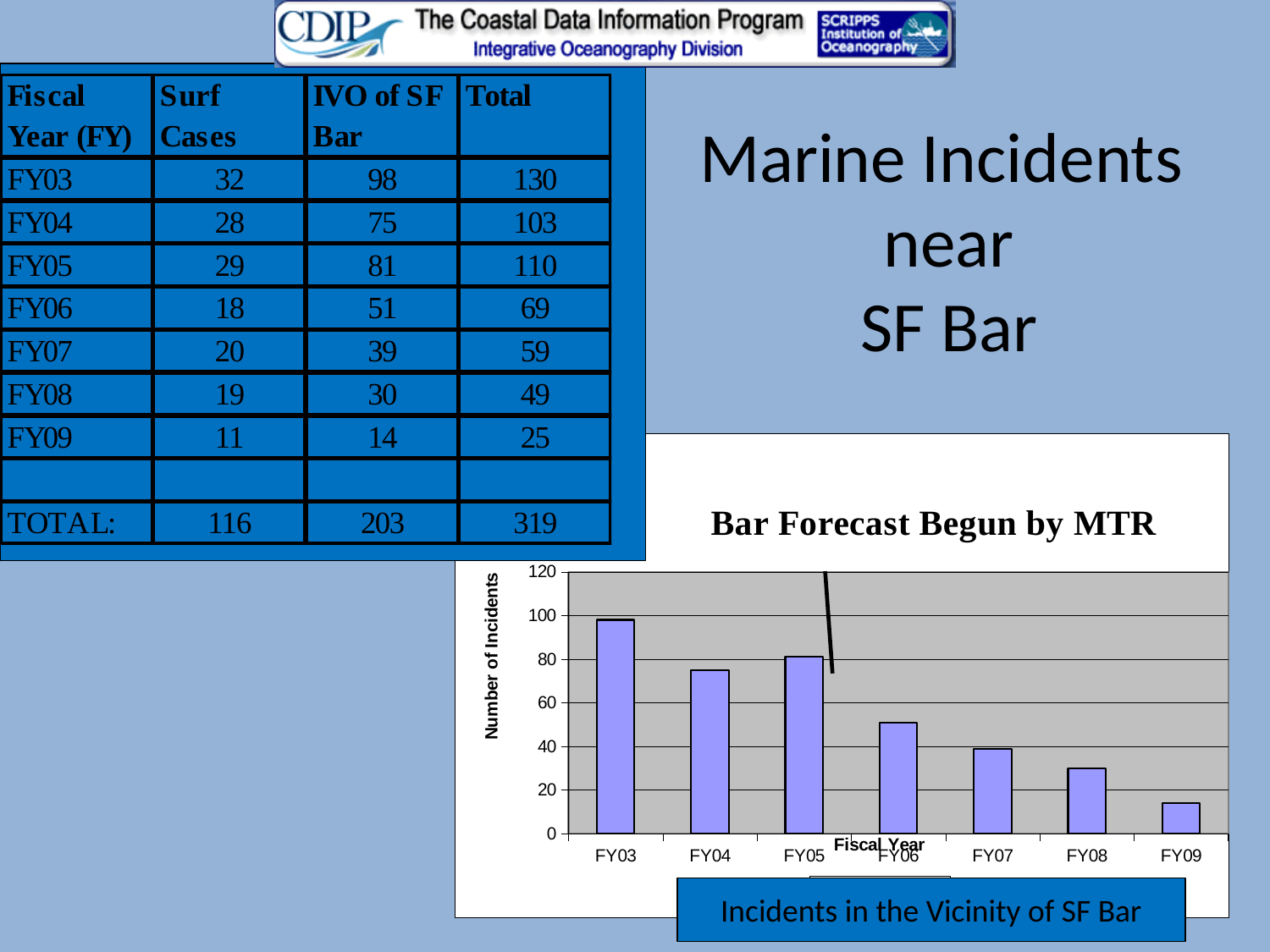
Do the values in the bar chart generally rise or fall from FY03 to FY09? fall Which fiscal year has the highest number of incidents in the bar chart? FY03 Is the value for FY09 in the bar chart greater or less than 20? less Is the value for FY04 in the bar chart greater or less than 60? greater In the bar chart, which has more incidents, FY03 or FY06? FY03 Is the value for FY03 in the bar chart greater or less than 80? greater Which fiscal year has the lowest number of incidents in the bar chart? FY09 What is the label on the vertical axis of the bar chart? Number of Incidents What kind of chart is shown on the slide? bar chart How many fiscal years are plotted on the bar chart? 7